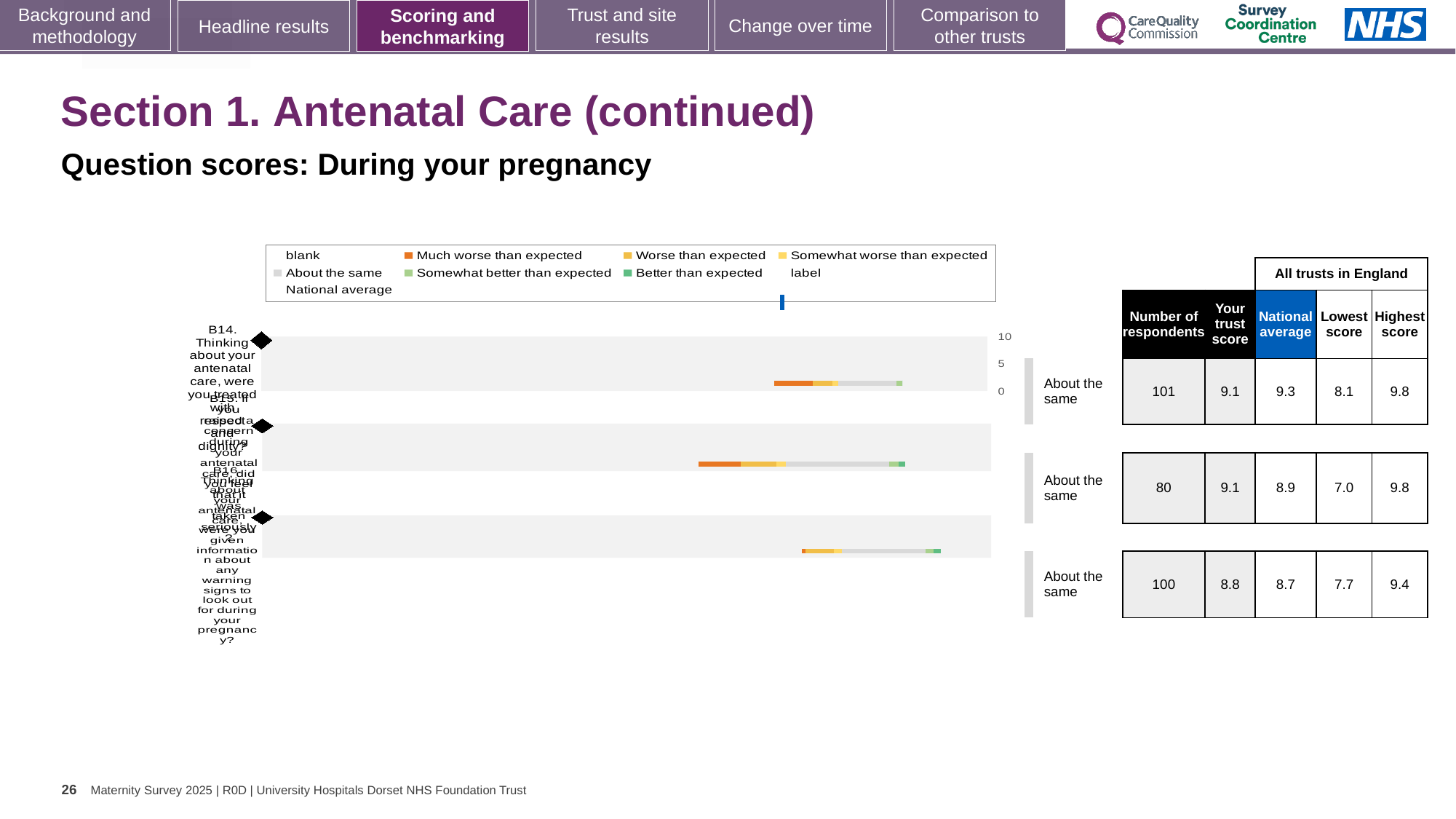
For the first question, B14, which is larger: the trust score or the national average? National average What is the national average for the second question, B15? 8.9 What is the number of respondents for the first question, B14? 101 Which question has the lowest 'Lowest score' among all trusts in England? B15 What benchmark category is shown for all three questions? About the same How many questions (bars) are plotted in the chart? 3 What is the difference between the highest score and the lowest score for the second question, B15? 2.8 What kind of chart is shown on the slide? Bar chart Which question has the highest number of respondents? B14 What is the lowest score among all trusts in England for the third question, B16? 7.7 What is the trust score for the third question, B16? 8.8 How many entries does the chart legend list? 9